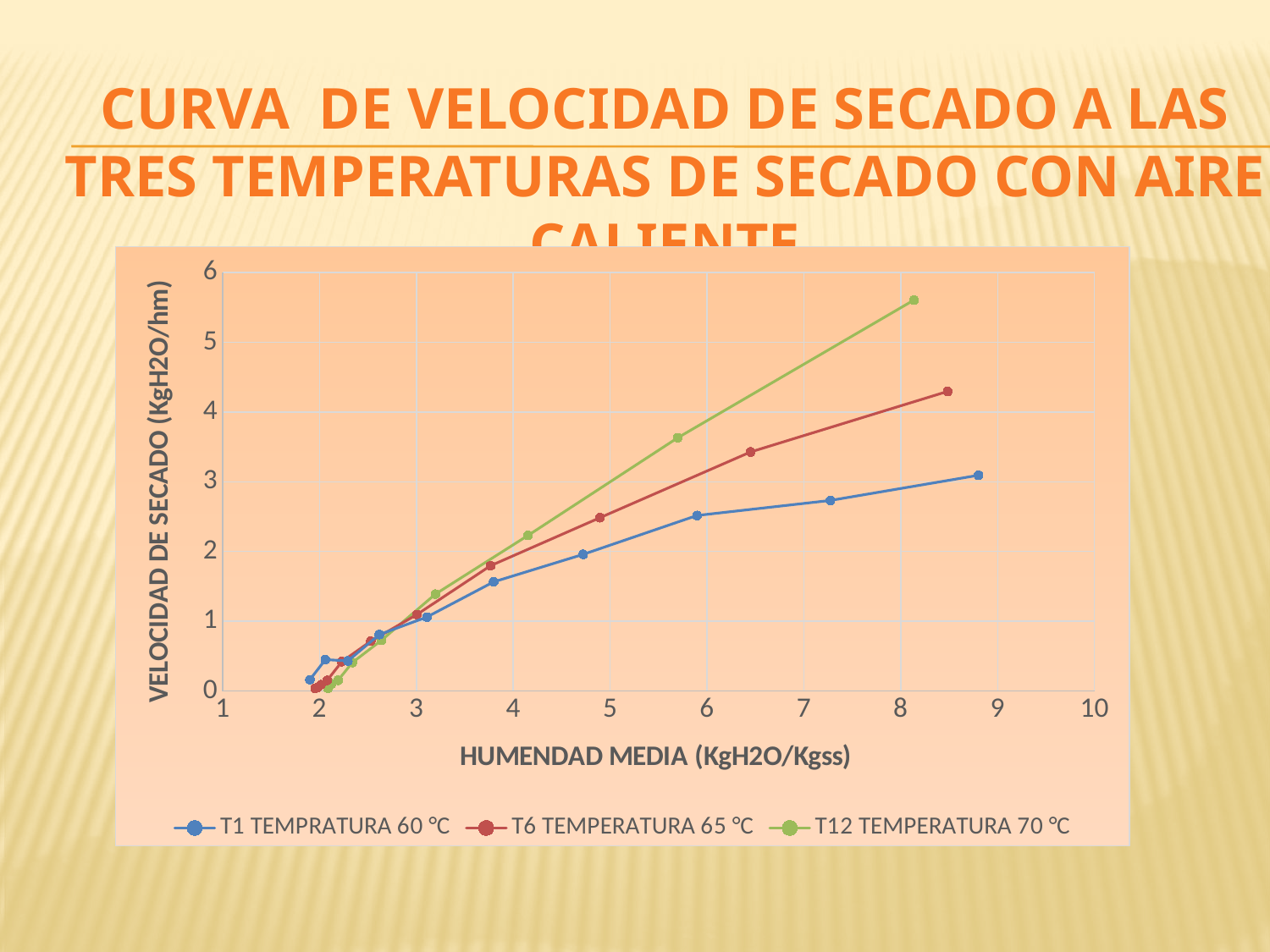
Is the highest value of the T6 TEMPERATURA 65 °C series greater or less than 4? greater What kind of chart is shown on the slide? line chart At a humidity of about 8, which series has the larger drying velocity, T6 TEMPERATURA 65 °C or T12 TEMPERATURA 70 °C? T12 TEMPERATURA 70 °C Do the drying velocity values generally rise or fall as the mean humidity increases along the x axis? rise Is the highest value of the T1 TEMPRATURA 60 °C series greater or less than 2? greater Is the highest value of the T1 TEMPRATURA 60 °C series greater or less than 4? less How many series does the legend list? 3 What is the title of the y axis? VELOCIDAD DE SECADO (KgH2O/hm) What is the title of the x axis? HUMENDAD MEDIA (KgH2O/Kgss) Which series has the lowest maximum drying velocity on the chart? T1 TEMPRATURA 60 °C Which series reaches the highest drying velocity on the chart? T12 TEMPERATURA 70 °C